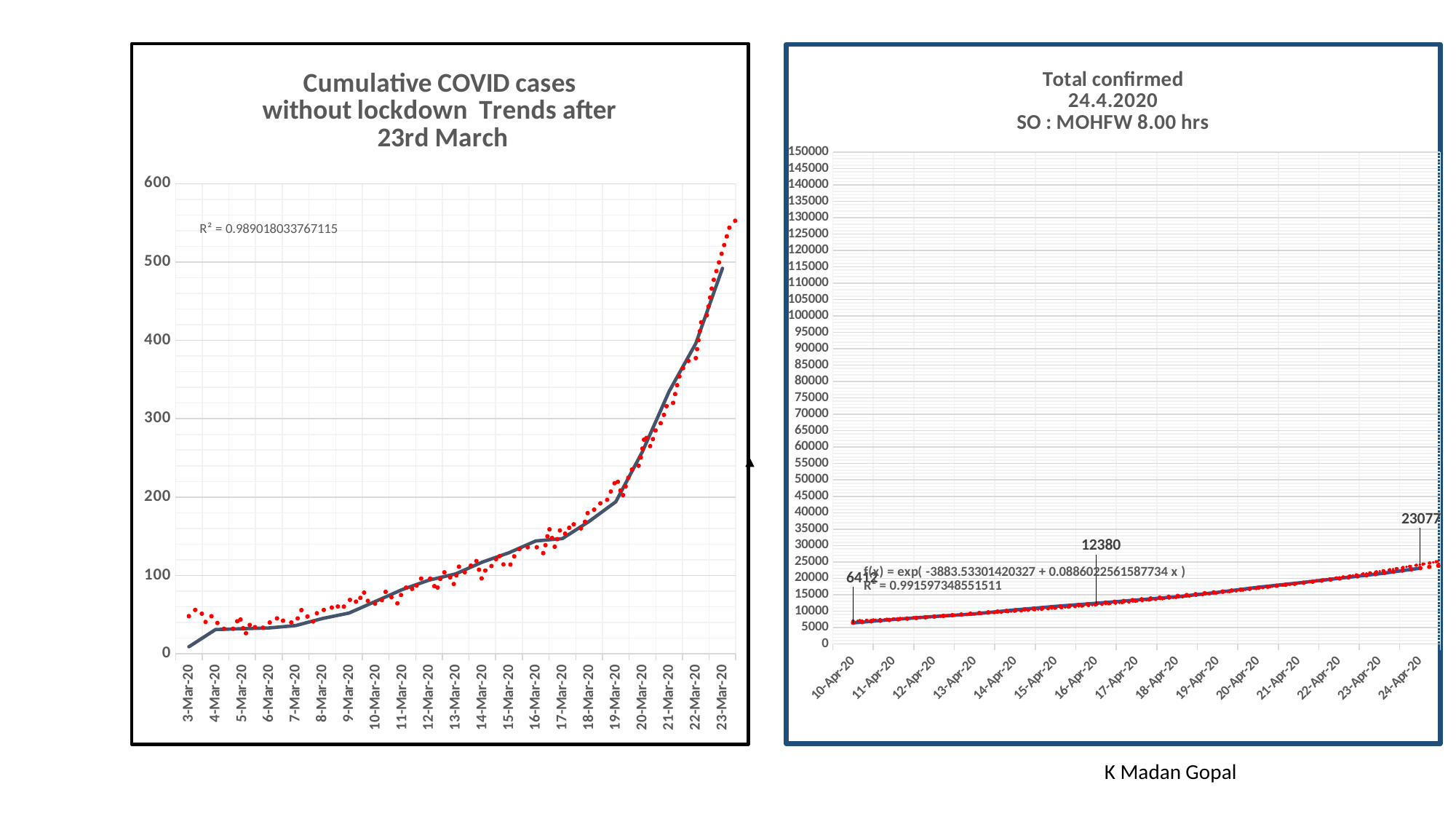
In the 'Total confirmed 24.4.2020' chart on the right, which is larger, the value for 24-Apr-20 or the value for 10-Apr-20? 24-Apr-20 What R² value is printed on the 'Cumulative COVID cases without lockdown' chart on the left? 0.989018033767115 In the 'Total confirmed 24.4.2020' chart on the right, what is the difference between the labelled values for 24-Apr-20 and 10-Apr-20? 16665 How many dates are shown on the x axis of the 'Total confirmed 24.4.2020' chart on the right? 15 In the 'Total confirmed 24.4.2020' chart on the right, what is the value labelled for 24-Apr-20? 23077 What kind of chart is the 'Cumulative COVID cases without lockdown' chart on the left? Line chart In the 'Total confirmed 24.4.2020' chart on the right, what is the value labelled for 10-Apr-20? 6412 How many dates are shown on the x axis of the 'Cumulative COVID cases without lockdown' chart on the left? 21 In the 'Cumulative COVID cases without lockdown' chart on the left, do the values rise or fall from 3-Mar-20 to 23-Mar-20? Rise In the 'Total confirmed 24.4.2020' chart on the right, what is the value labelled for 16-Apr-20? 12380 In the 'Total confirmed 24.4.2020' chart on the right, what is the difference between the labelled values for 16-Apr-20 and 10-Apr-20? 5968 In the 'Cumulative COVID cases without lockdown' chart on the left, is the value for 23-Mar-20 greater or less than 400? greater